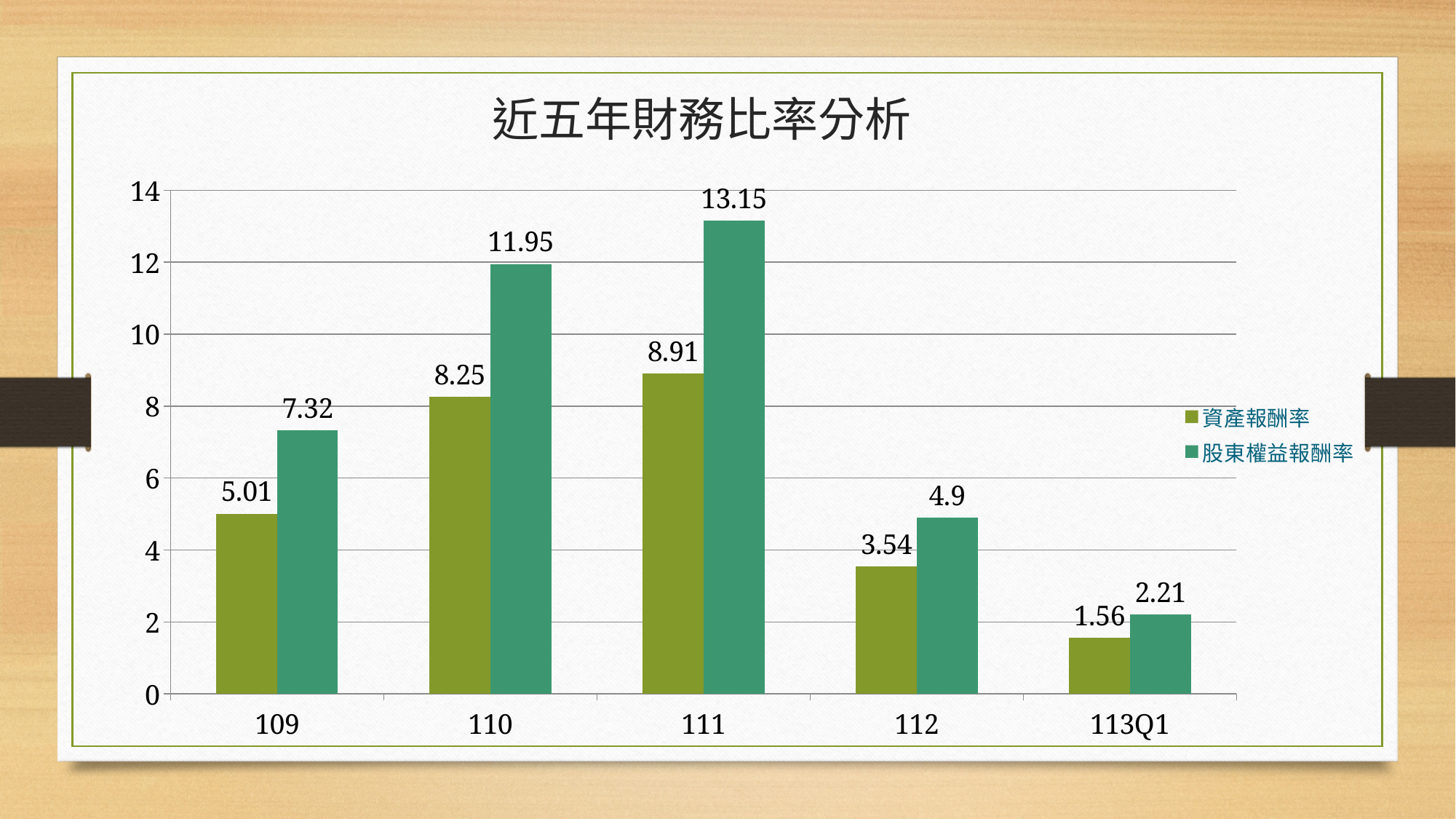
Which category has the lowest 資產報酬率? 113Q1 What is the value of 股東權益報酬率 for 112? 4.9 Which category has the highest 股東權益報酬率? 111 How many categories are shown on the x axis? 5 What kind of chart is shown on the slide? Bar chart What is the title of the chart? 近五年財務比率分析 What is the value of 股東權益報酬率 for 113Q1? 2.21 What is the value of 資產報酬率 for 110? 8.25 What is the difference between 股東權益報酬率 and 資產報酬率 for 111? 4.24 How many series does the legend list? 2 What is the difference in 資產報酬率 between 110 and 109? 3.24 Which is larger: 股東權益報酬率 for 109 or 資產報酬率 for 111? 資產報酬率 for 111